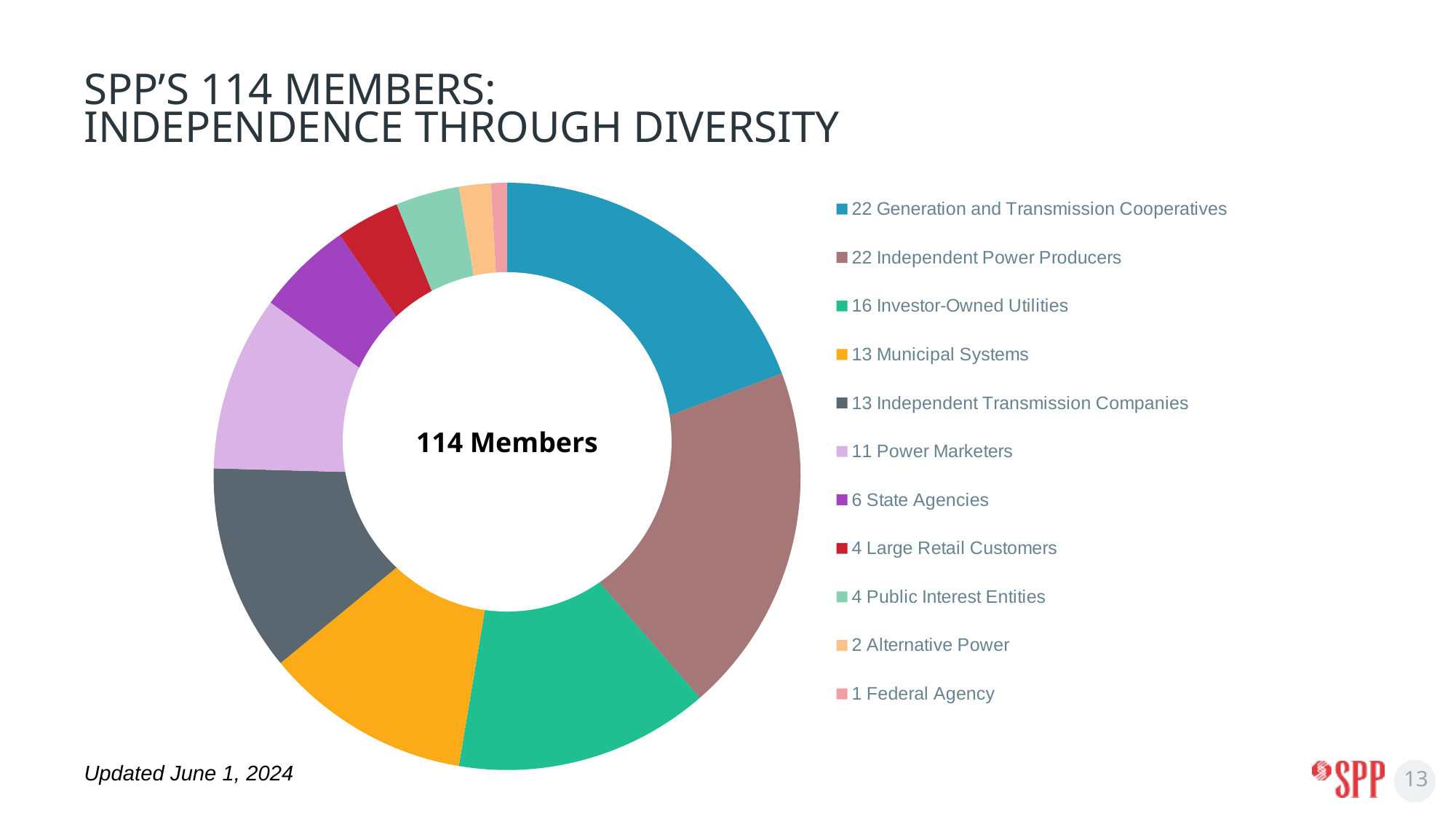
Which member category has the smallest number of members? Federal Agency Which category has more members: Investor-Owned Utilities or Municipal Systems? Investor-Owned Utilities What total number of members is shown in the center of the chart? 114 Members How many Investor-Owned Utilities are shown in the chart legend? 16 Which category has more members: Large Retail Customers or Alternative Power? Large Retail Customers How many Generation and Transmission Cooperatives are SPP members according to the chart? 22 What is the difference between the number of Independent Power Producers and the number of Investor-Owned Utilities? 6 What is the difference between the number of Municipal Systems and the number of Power Marketers? 2 How many member categories does the chart show? 11 How many State Agencies are SPP members according to the chart? 6 What type of chart is used on this slide? Pie chart How many Power Marketers are listed in the chart? 11